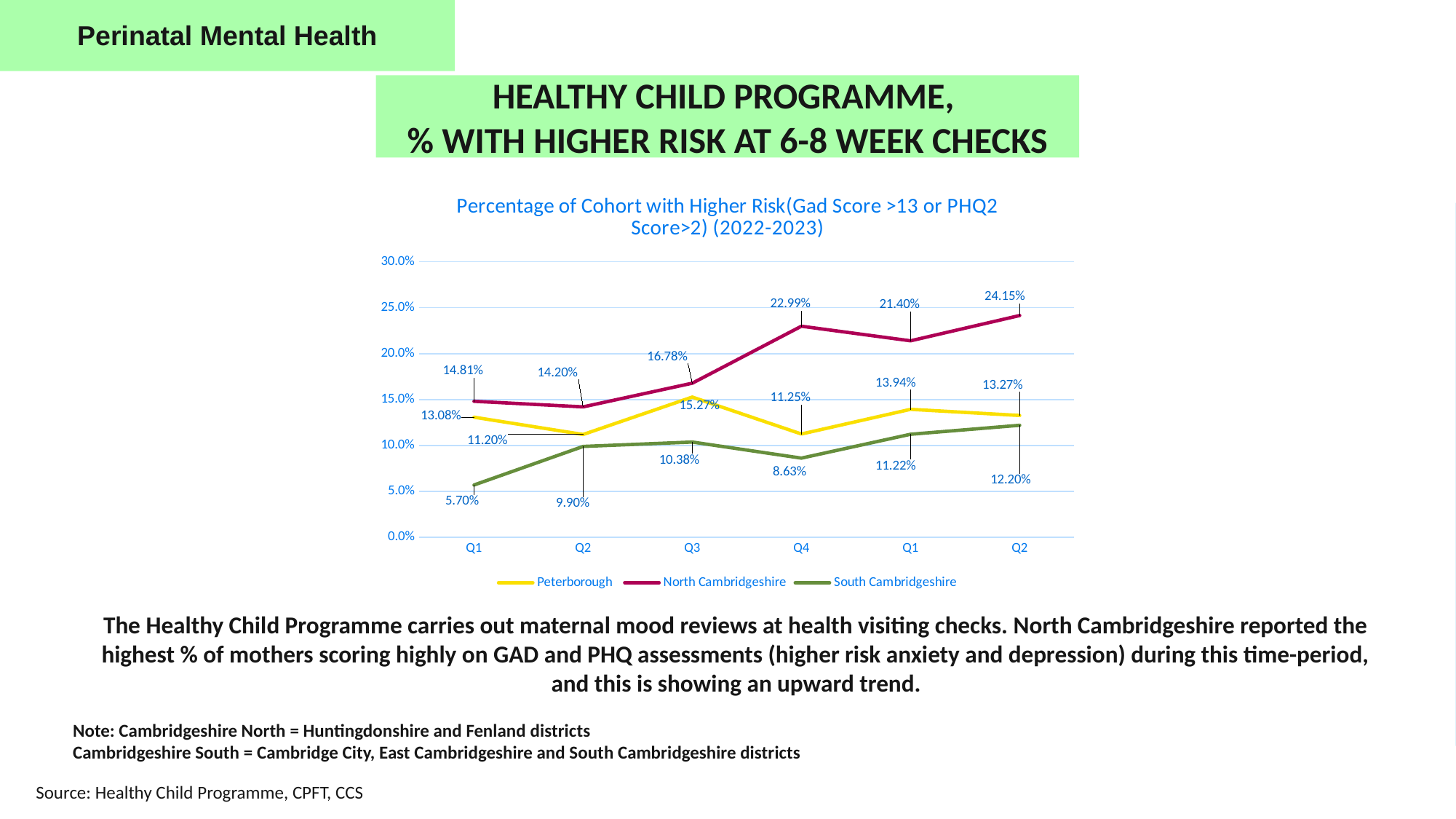
What is the highest value plotted for North Cambridgeshire? 24.15% Does the South Cambridgeshire line rise or fall overall from the first Q1 to the final Q2? rises What is the value for North Cambridgeshire at Q4? 22.99% How many quarters are plotted along the x axis? 6 At the final Q2, what is the difference between North Cambridgeshire (24.15%) and Peterborough (13.27%)? 10.88% At Q3, which is larger: Peterborough or North Cambridgeshire? North Cambridgeshire What is the value for Peterborough at the first Q1? 13.08% Which series has the highest value at Q4? North Cambridgeshire How many series does the legend list? 3 What kind of chart is shown on the slide? line chart What is the lowest value plotted for South Cambridgeshire? 5.70% What is the value for South Cambridgeshire at Q3? 10.38%